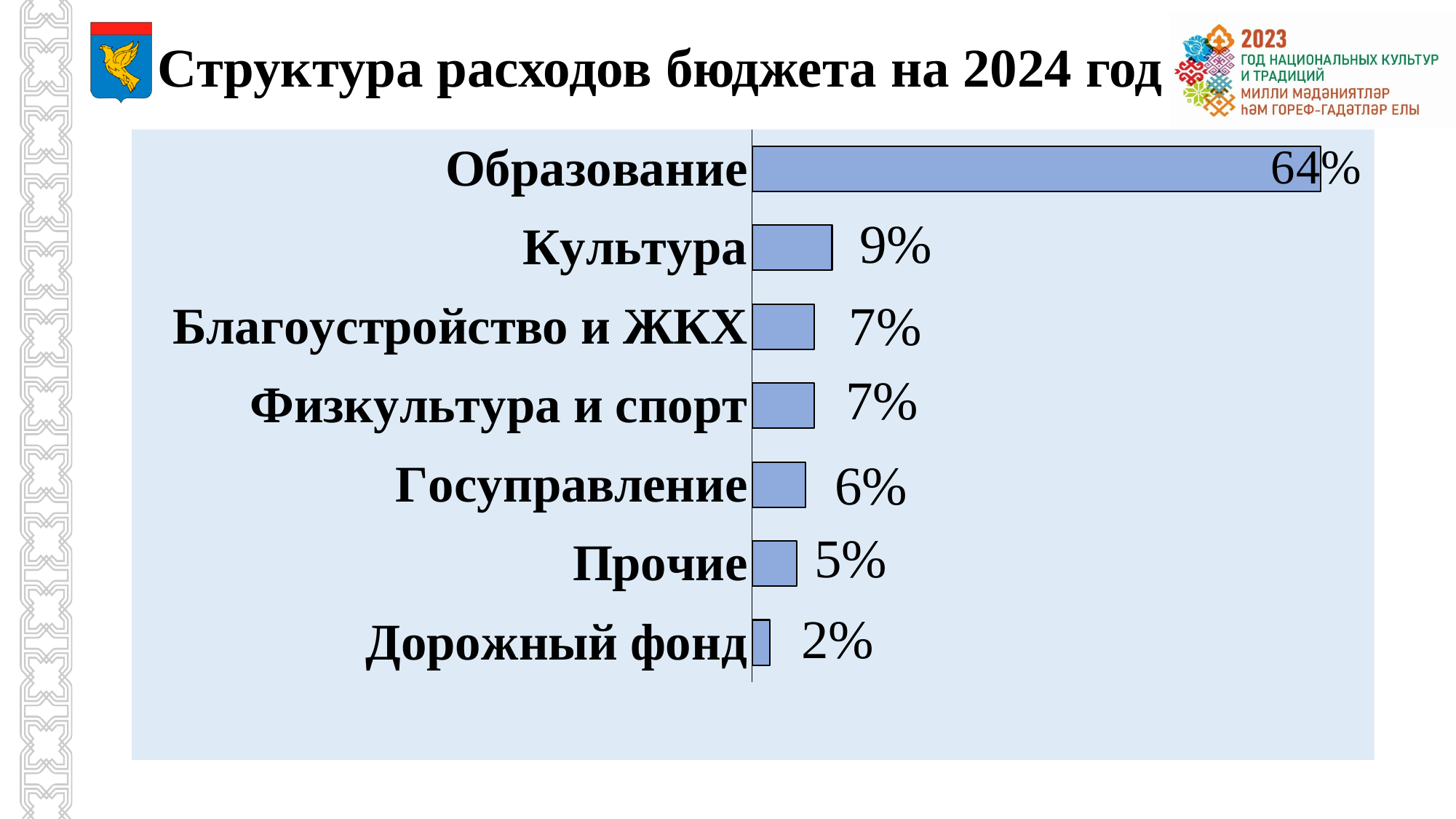
What is the value for Дорожный фонд? 2% What is the difference between the values for Госуправление and Прочие? 1% Which category has the highest value? Образование What is the difference between the values for Образование and Культура? 55% Which is larger, the value for Культура or the value for Благоустройство и ЖКХ? Культура What kind of chart is shown on the slide? Bar chart What is the value for Культура? 9% Which category has the lowest value? Дорожный фонд How many categories are shown in the chart? 7 What is the value for Госуправление? 6% What is the value for Образование? 64% What is the title of the slide? Структура расходов бюджета на 2024 год